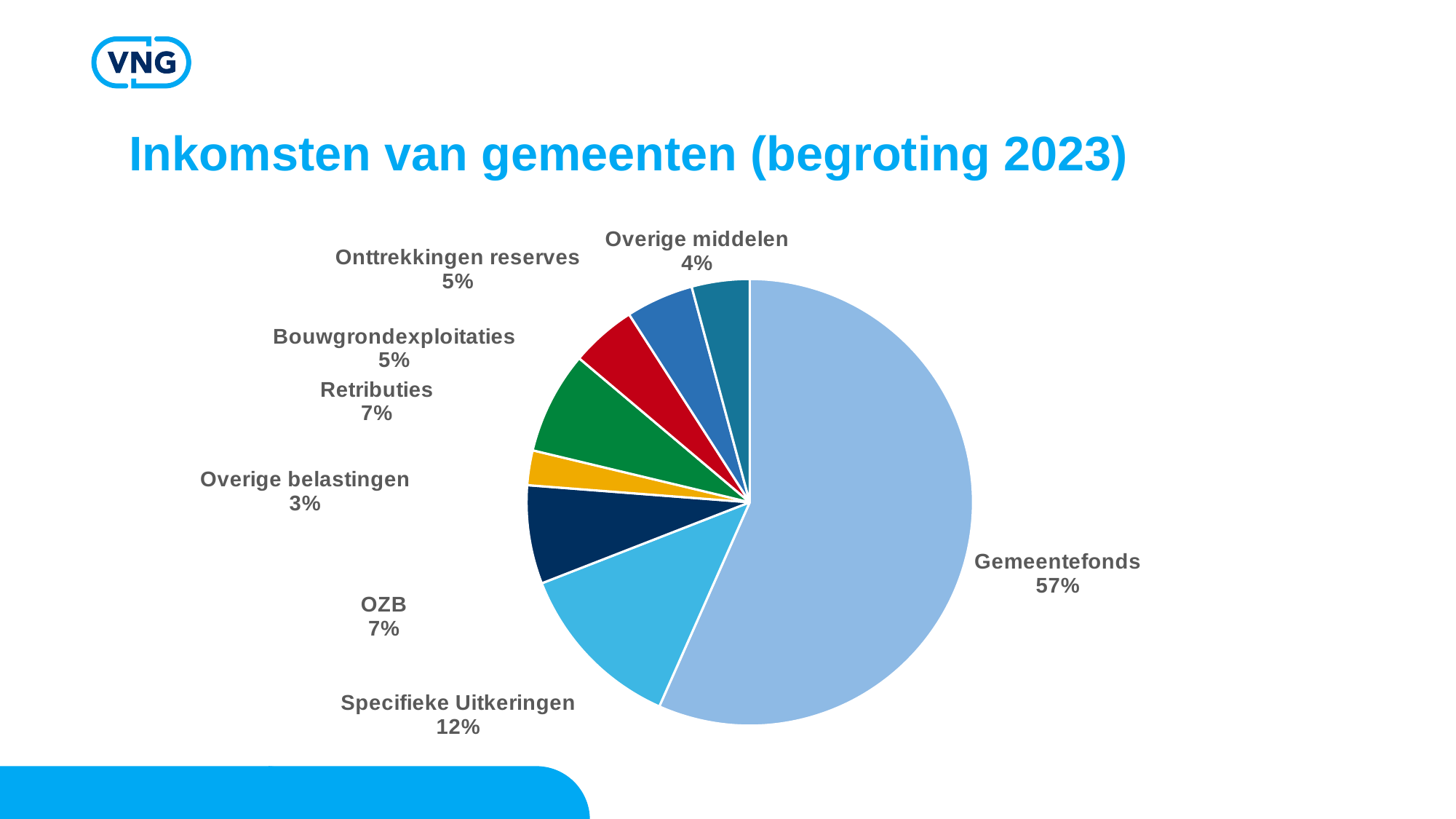
What is the value shown for Specifieke Uitkeringen? 12% What is the value shown for Overige belastingen? 3% What is the title of the slide containing the pie chart? Inkomsten van gemeenten (begroting 2023) What share of the pie does Gemeentefonds represent? 57% How many categories (slices) does the pie chart have? 8 What is the difference between the shares of Gemeentefonds and Specifieke Uitkeringen? 45% What kind of chart is shown on the slide? pie chart What is the combined share of OZB and Overige belastingen? 10% Which category has the smallest slice of the pie? Overige belastingen Which category has the largest slice of the pie? Gemeentefonds What is the value shown for Overige middelen? 4% Which is larger, the share for Retributies or the share for Bouwgrondexploitaties? Retributies